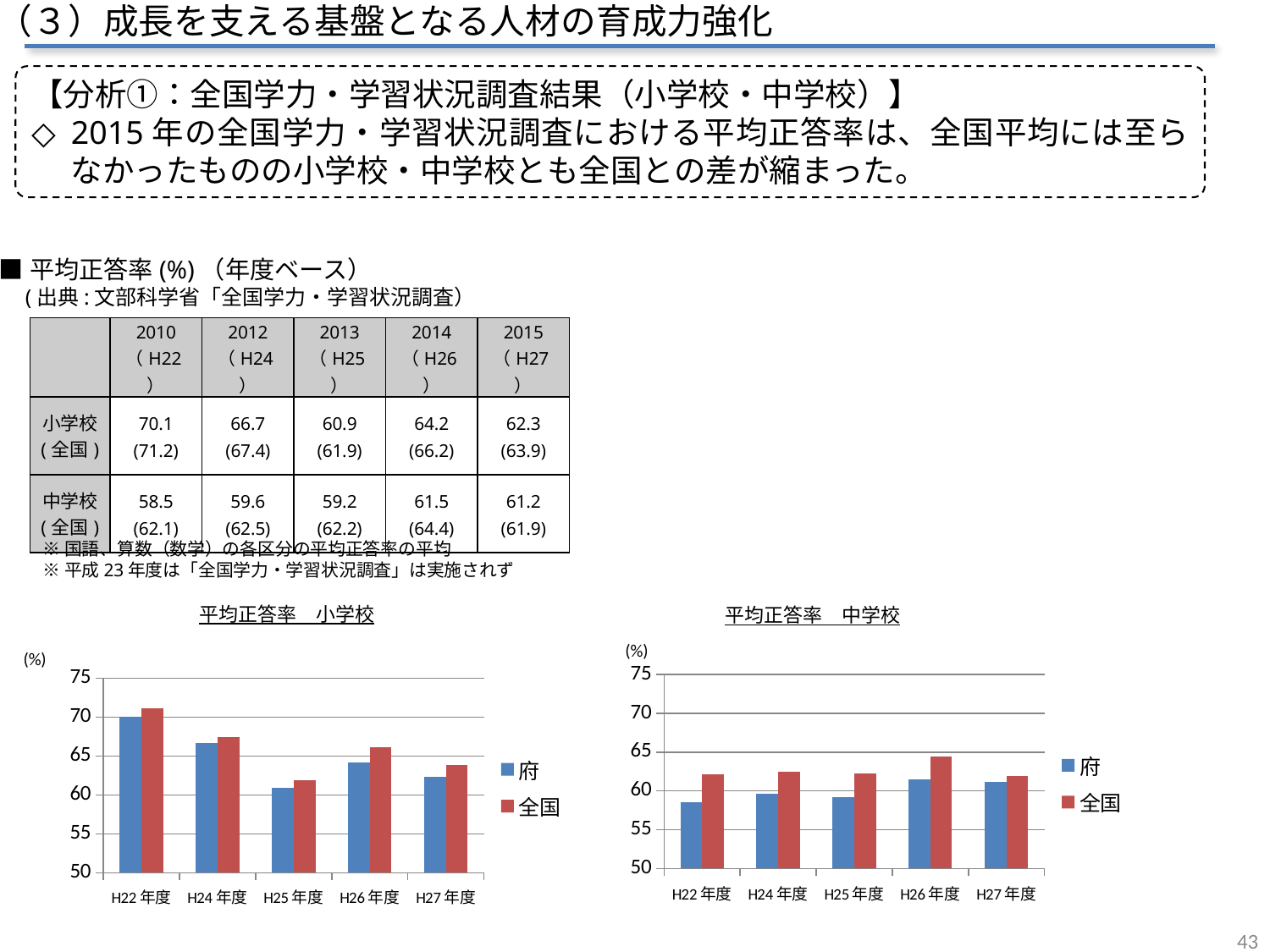
In the 平均正答率 中学校 chart, is the value for 府 in H22年度 greater or less than 60? less How many year categories are shown on the x axis of the 平均正答率 中学校 chart? 5 What kind of chart is the 平均正答率 小学校 chart on the left? bar chart In the 平均正答率 中学校 chart, in which year is the 全国 bar highest? H26年度 In the 平均正答率 小学校 chart, is the value for 府 in H22年度 greater or less than 65? greater In the 平均正答率 小学校 chart, what is the difference between 全国 and 府 in H27年度? 1.6 In the 平均正答率 小学校 chart, does the 府 value rise or fall from H22年度 to H25年度? fall In the 平均正答率 小学校 chart, which is larger in H25年度, 府 or 全国? 全国 How many series does the legend of the 平均正答率 中学校 chart list? 2 In the 平均正答率 小学校 chart, in which year is the 府 bar highest? H22年度 In the 平均正答率 小学校 chart, what is the value for 府 in H22年度? 70.1 In the 平均正答率 中学校 chart, what is the value for 全国 in H26年度? 64.4